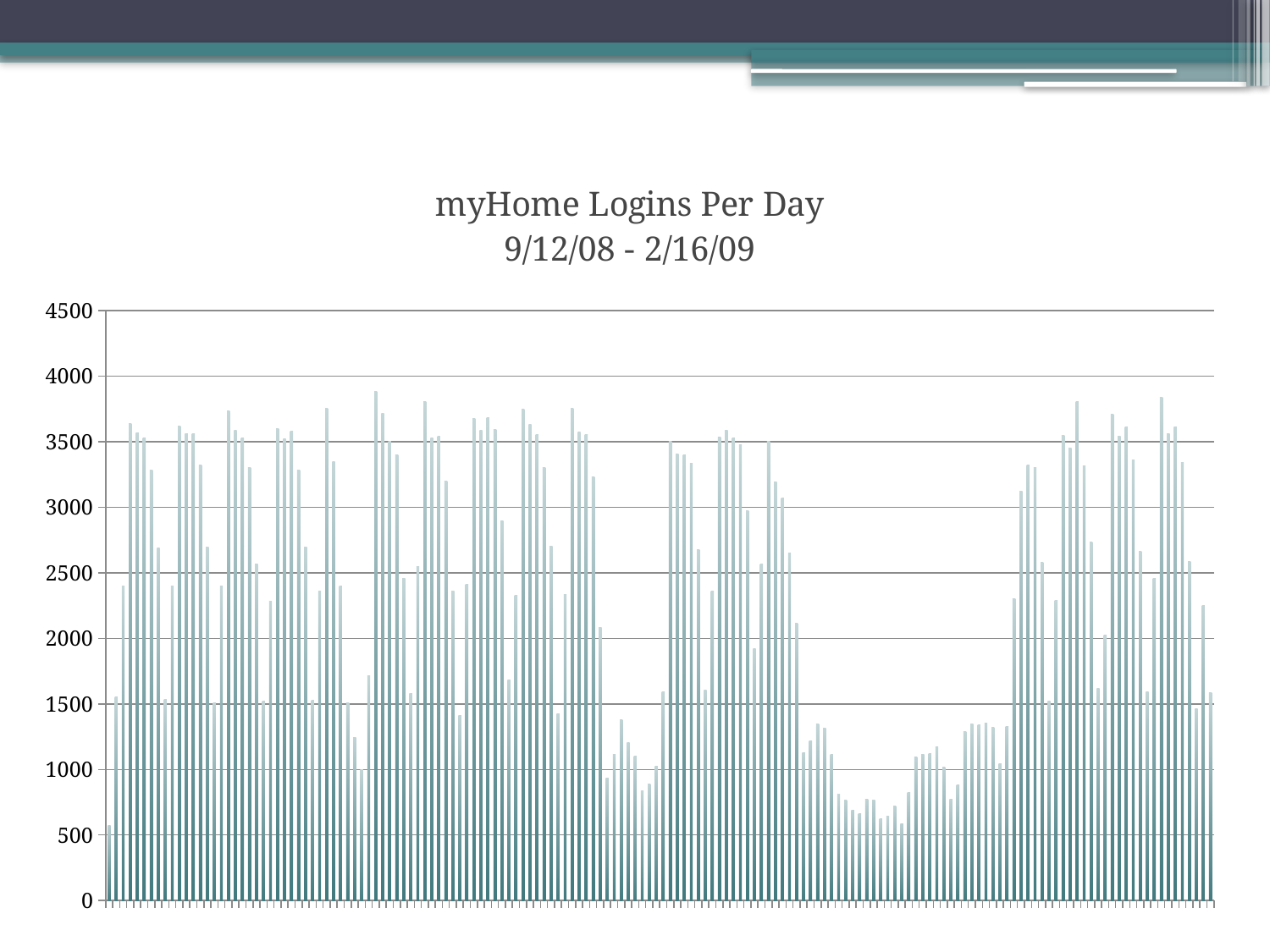
Is the tallest bar in the chart greater or less than 3500? greater What is the title of the chart? myHome Logins Per Day 9/12/08 - 2/16/09 Is the tallest bar in the chart greater or less than 4000? less Does any bar in the chart reach the 4500 line at the top of the y axis? no What kind of chart is shown on the slide? bar chart What date range does the chart title say the data covers? 9/12/08 - 2/16/09